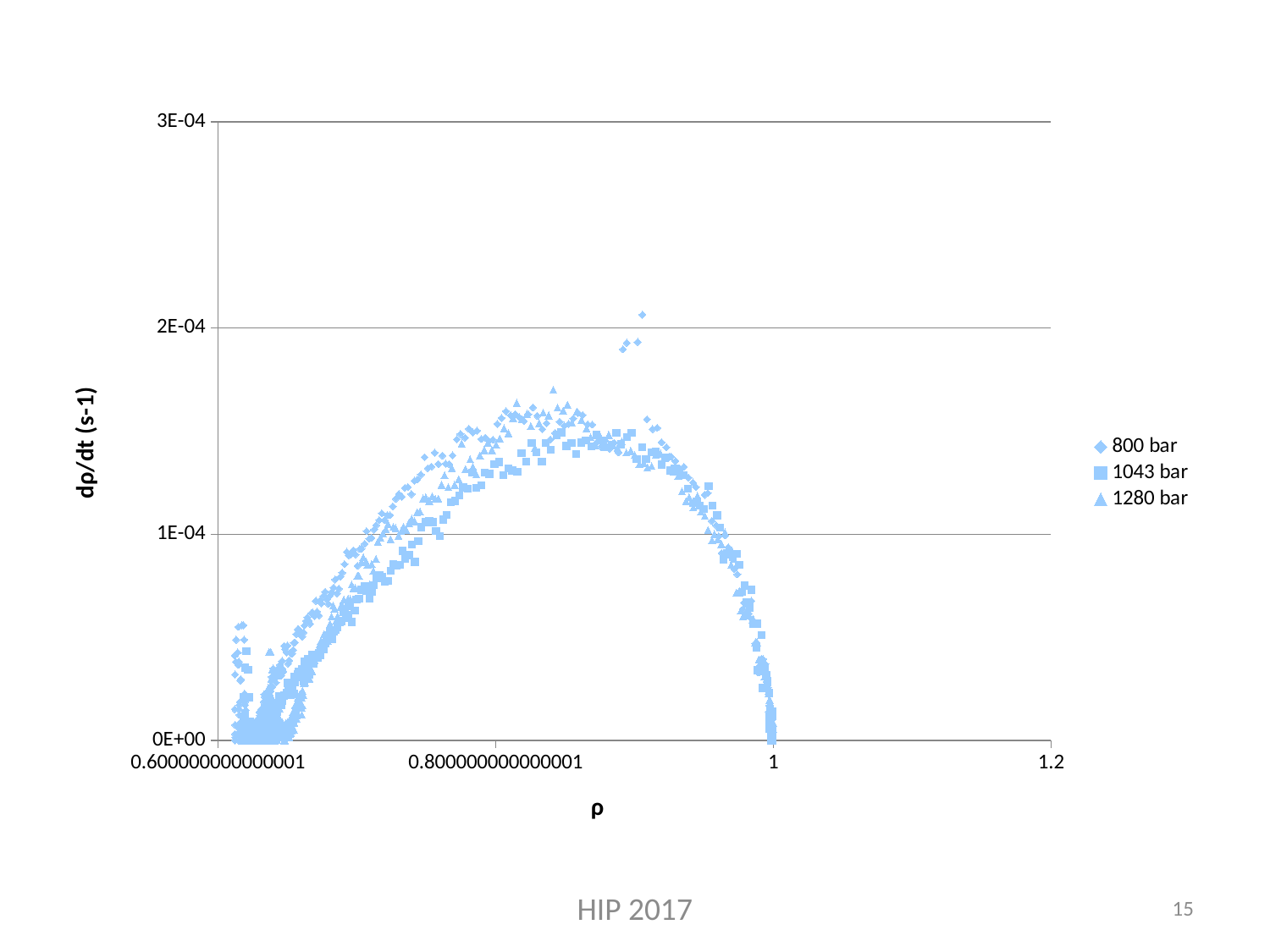
Do the plotted values rise or fall as ρ increases from about 0.8 to 1? fall What is the highest value shown on the x axis? 1.2 How many series does the legend list? 3 Is the highest plotted value for the 800 bar series greater or less than 3E-04? less What is the title of the y axis? dρ/dt (s-1) What is the highest value shown on the y axis? 3E-04 Do the plotted values rise or fall as ρ increases from about 0.65 to 0.8? rise Is the highest plotted value for the 1043 bar series greater or less than 2E-04? less Is the highest plotted value for the 1280 bar series greater or less than 2E-04? less What are the three series named in the legend? 800 bar, 1043 bar, 1280 bar What kind of chart is shown on the slide? scatter chart Which series reaches the highest plotted value of dρ/dt? 800 bar